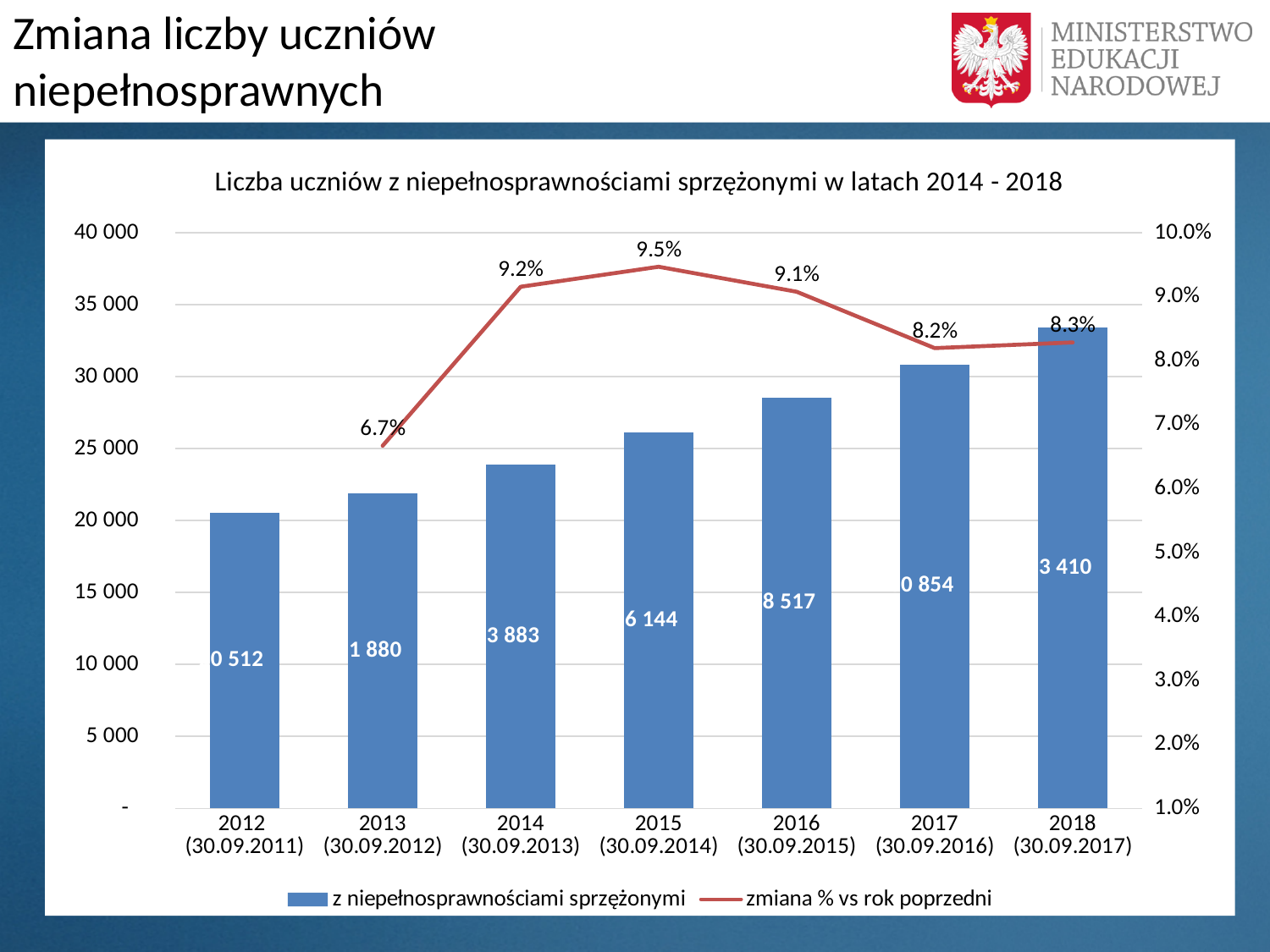
Which is larger: the percentage change for 2014 or for 2016? 2014 (9.2%) How many years are shown on the x axis of the chart? 7 Is the number of students with multiple disabilities in 2012 (30.09.2011) greater or less than 25 000? less What is the value of the 'zmiana % vs rok poprzedni' line for 2015 (30.09.2014)? 9.5% What is the difference between the percentage change for 2015 and for 2013? 2.8 percentage points In which year does the 'zmiana % vs rok poprzedni' line reach its highest value? 2015 (30.09.2014) What is the percentage change shown for 2018 (30.09.2017)? 8.3% Do the bars for students with multiple disabilities rise or fall from 2012 to 2018? rise What percentage change is shown for 2013 (30.09.2012)? 6.7% How many series does the legend list? 2 In which year is the percentage change line at its lowest value? 2013 (30.09.2012) Is the number of students with multiple disabilities in 2018 (30.09.2017) greater or less than 30 000? greater